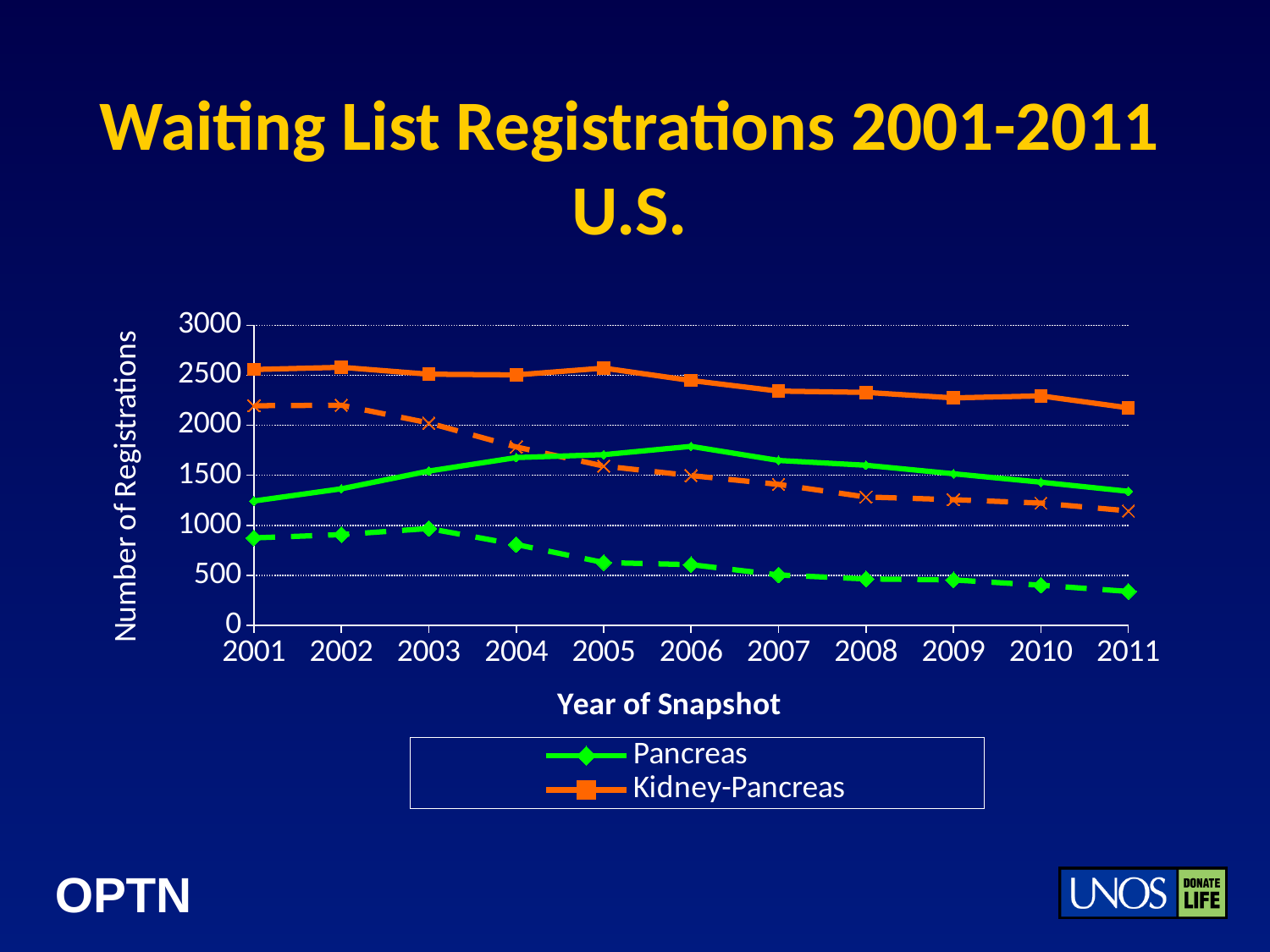
In 2005, which solid line is higher, Pancreas or Kidney-Pancreas? Kidney-Pancreas What is the title of the x axis? Year of Snapshot Is the value for the solid Pancreas line in 2001 greater or less than 1000? greater Is the value for the solid Pancreas line in 2011 greater or less than 1500? less Does the solid Pancreas line rise or fall from 2001 to 2006? rise How many years are shown along the x axis? 11 Does the solid Kidney-Pancreas line rise or fall from 2006 to 2011? fall Is the value for the solid Pancreas line in 2006 greater or less than 1500? greater How many series does the legend list? 2 What kind of chart is shown on the slide? line chart